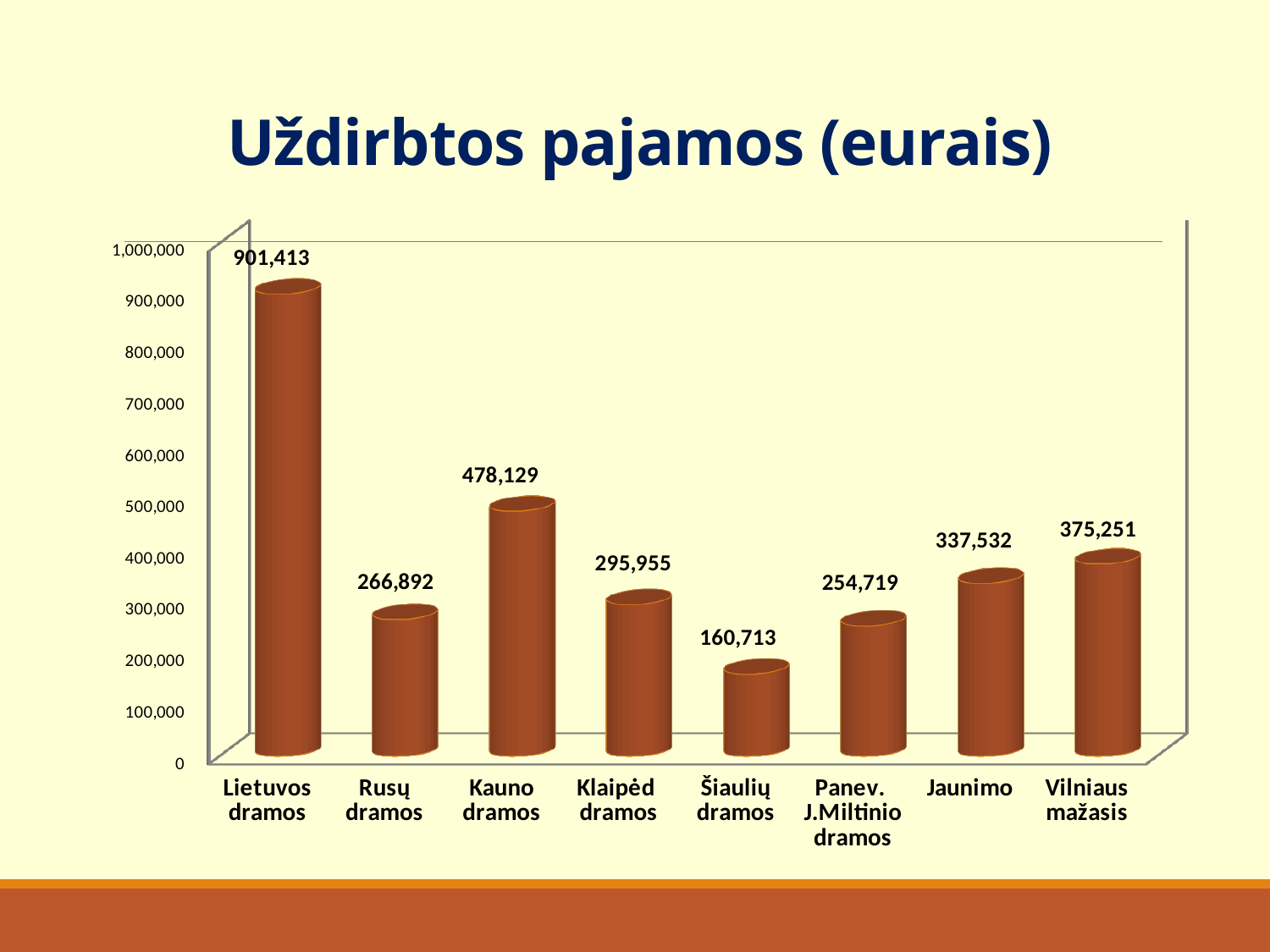
Is the value for Kauno dramos greater or less than 400,000? greater Which is larger, the value for Jaunimo or the value for Rusų dramos? Jaunimo How many categories are shown on the chart? 8 What is the value for Šiaulių dramos? 160,713 What is the difference between the values for Kauno dramos and Klaipėd dramos? 182,174 What is the value for Panev. J.Miltinio dramos? 254,719 What is the title of the chart? Uždirbtos pajamos (eurais) What is the value for Lietuvos dramos? 901,413 Which category has the highest value? Lietuvos dramos What is the value for Vilniaus mažasis? 375,251 What kind of chart is shown on the slide? bar chart Which category has the lowest value? Šiaulių dramos